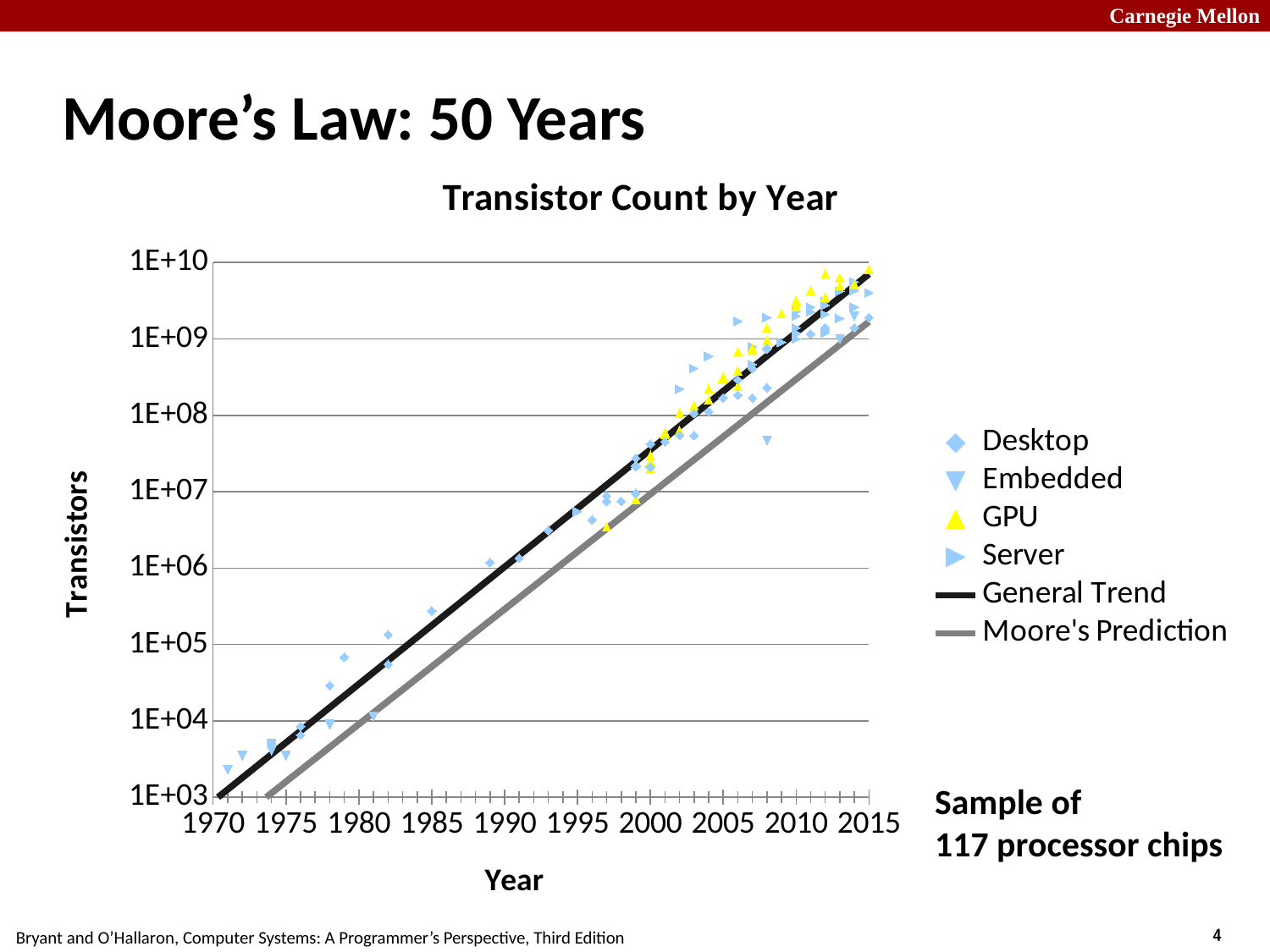
Which line is higher on the chart, General Trend or Moore's Prediction? General Trend What is the highest value shown on the Transistors axis? 1E+10 Is the Moore's Prediction line at 1990 greater or less than 1E+06 transistors? less Do transistor counts rise or fall as the year increases along the x axis? rise Which series is plotted with yellow triangles? GPU What is the first year shown on the x axis? 1970 How many processor chips are in the sample plotted on the chart? 117 What kind of chart is shown on the slide? scatter chart Is the General Trend line at 2000 greater or less than 1E+07 transistors? greater What is the title of the chart? Transistor Count by Year Is the General Trend line at 2015 greater or less than 1E+09 transistors? greater How many series does the legend list? 6